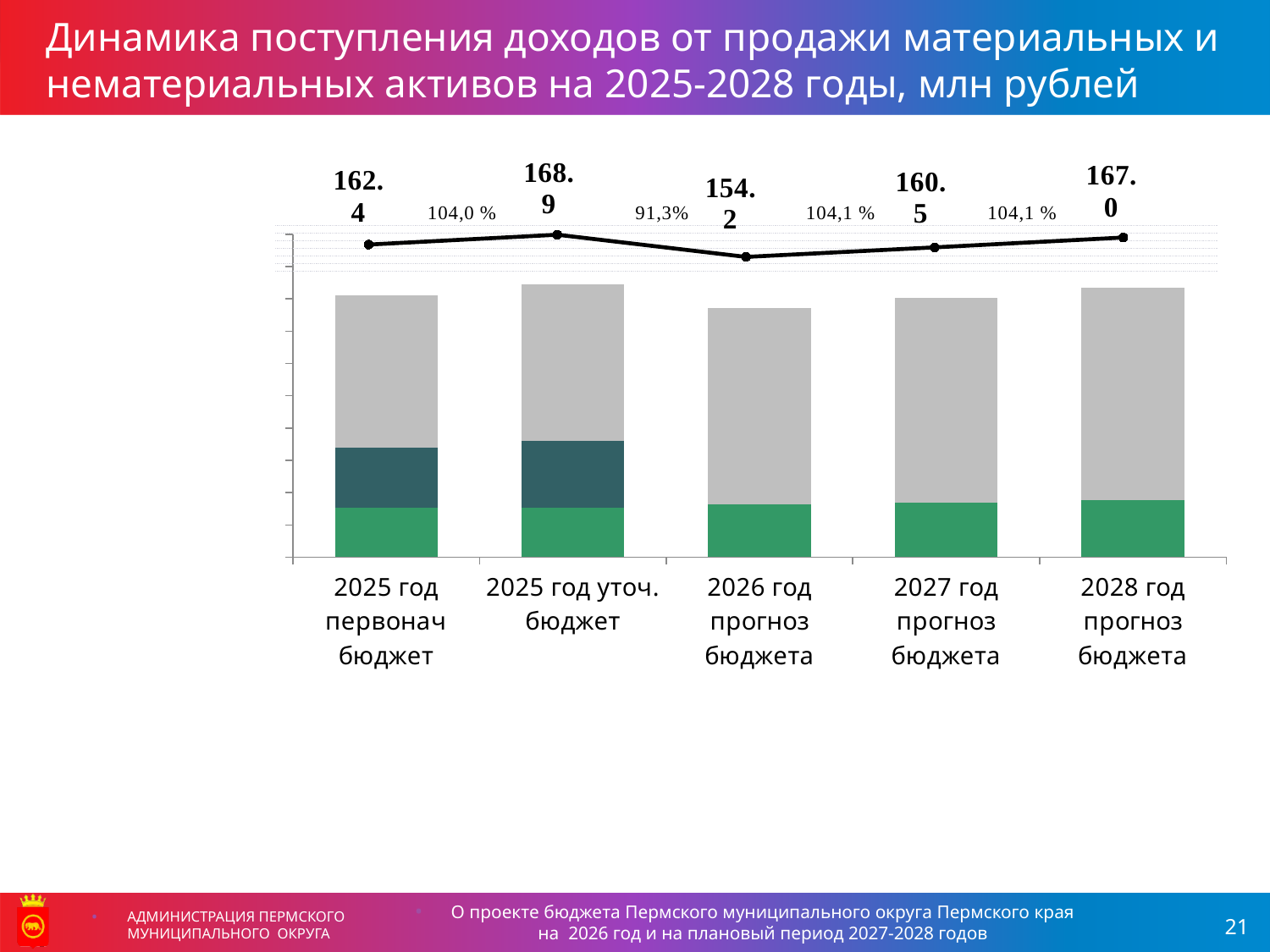
What is the difference between the labelled values for "2025 год уточ. бюджет" and "2026 год прогноз бюджета"? 14.7 Which has the larger labelled value, "2027 год прогноз бюджета" or "2028 год прогноз бюджета"? 2028 год прогноз бюджета What kind of chart is this? Combined stacked bar and line chart Do the labelled values rise or fall from "2026 год прогноз бюджета" to "2028 год прогноз бюджета"? Rise Which category has the highest labelled value? 2025 год уточ. бюджет How many categories are shown on the x axis? 5 What value is labelled for "2028 год прогноз бюджета"? 167.0 What value is labelled for "2026 год прогноз бюджета" on the line? 154.2 What percentage is shown between "2025 год уточ. бюджет" and "2026 год прогноз бюджета"? 91,3% What is the difference between the labelled values for "2025 год уточ. бюджет" and "2025 год первонач бюджет"? 6.5 What value is labelled for "2025 год уточ. бюджет"? 168.9 Which category has the lowest labelled value? 2026 год прогноз бюджета